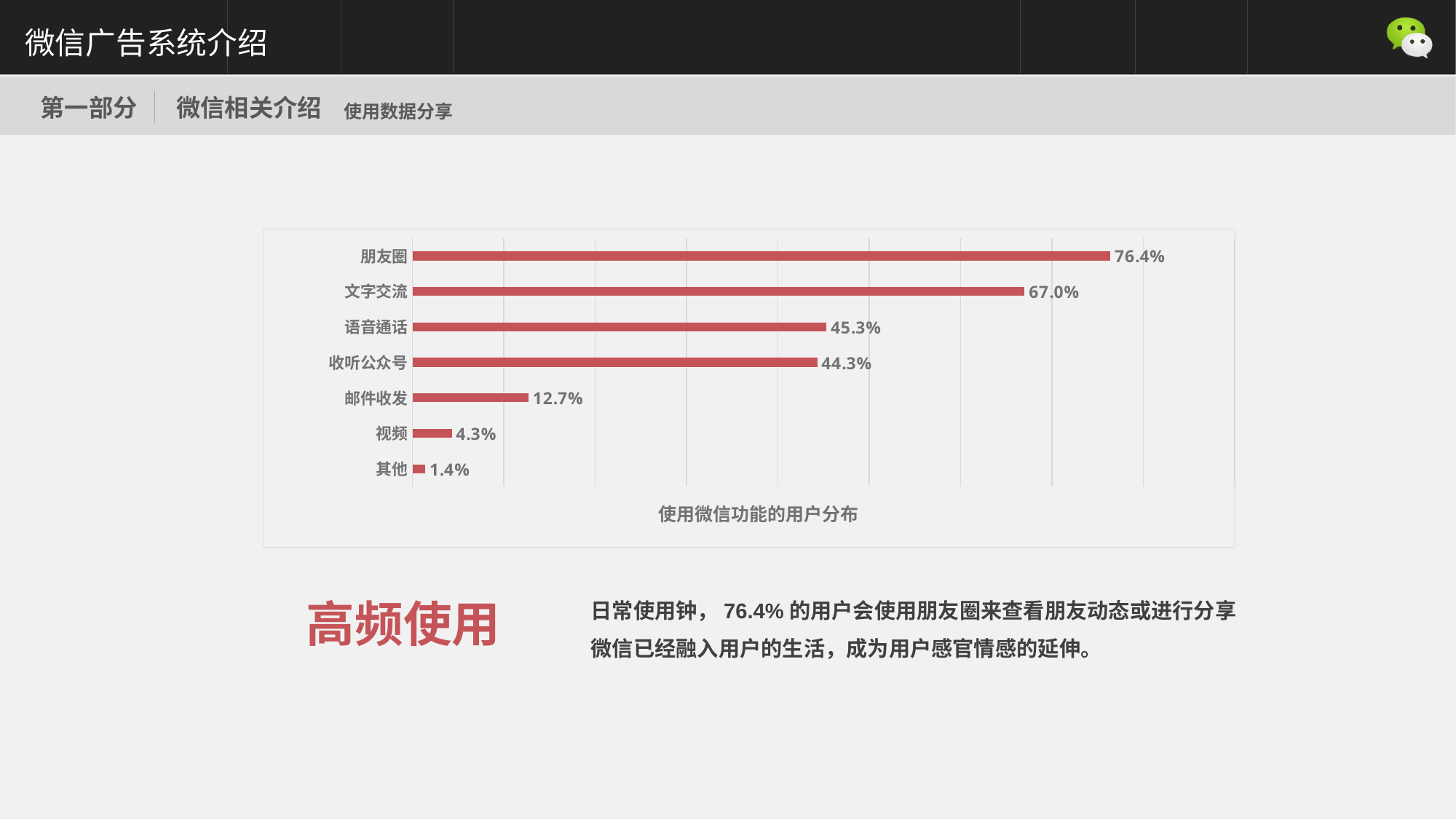
Which category has the highest value? 朋友圈 Which category has the lowest value? 其他 How many categories are shown in the chart? 7 What is the difference between the values for 语音通话 and 收听公众号? 1.0% What is the title of the chart? 使用微信功能的用户分布 What is the value for 邮件收发? 12.7% What colour are the bars in the chart? red What is the value for 收听公众号? 44.3% Which is larger, the value for 视频 or the value for 邮件收发? 邮件收发 What is the difference between the values for 朋友圈 and 文字交流? 9.4% What is the value for 朋友圈? 76.4% What kind of chart is shown on the slide? bar chart